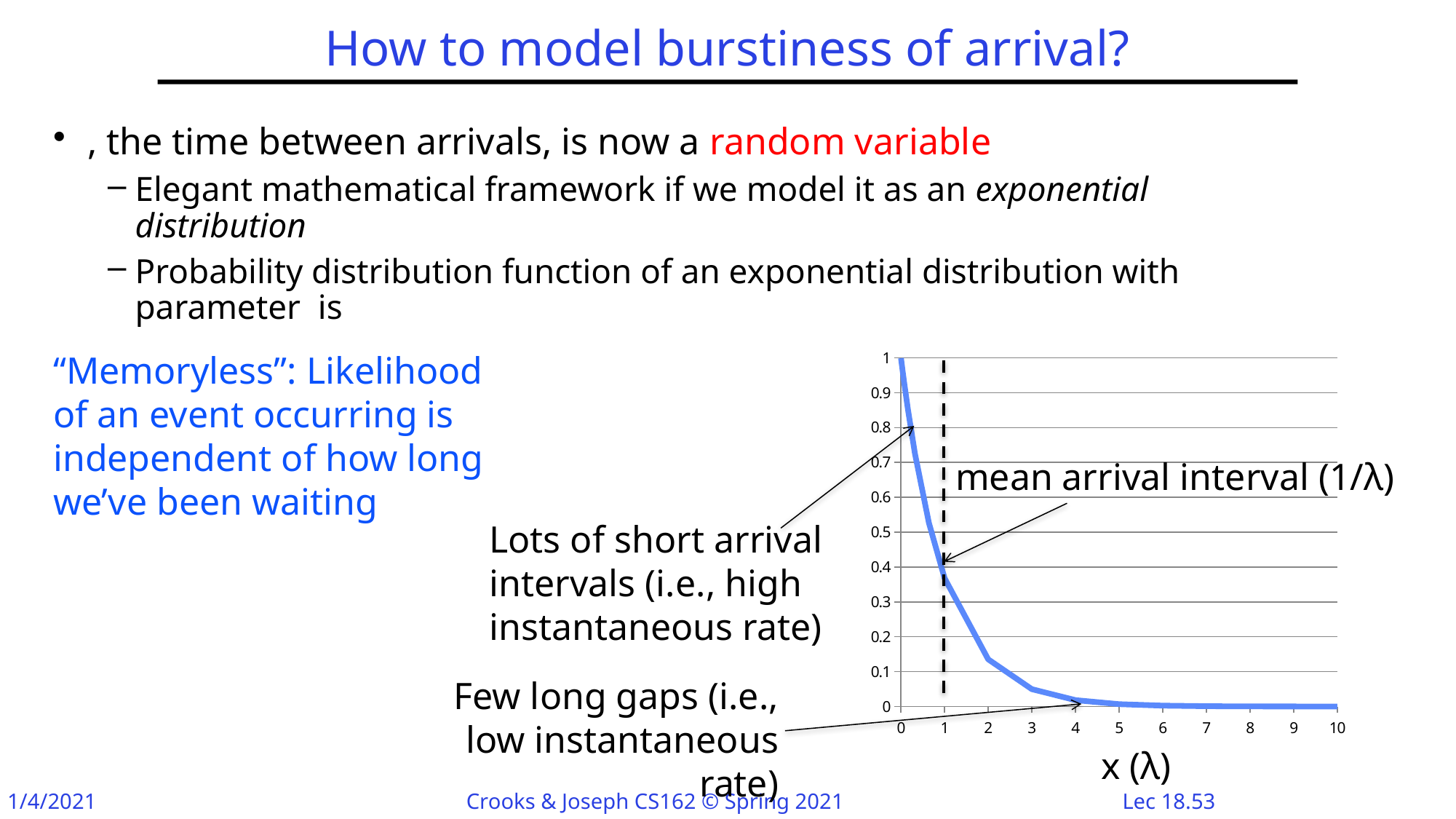
What kind of chart is shown on the slide? line chart Do the plotted values rise or fall as x increases along the x axis? fall What is the label of the x axis? x (λ) At which x value is the plotted curve highest? 0 Is the plotted value at x = 5 greater or less than 0.1? less Is the plotted value at x = 1 greater or less than 0.5? less How many tick labels are shown on the x axis? 11 Which is larger, the plotted value at x = 1 or at x = 4? x = 1 Is the plotted value at x = 2 greater or less than 0.2? less At which x value is the dashed vertical line marking the mean arrival interval (1/λ) drawn? 1